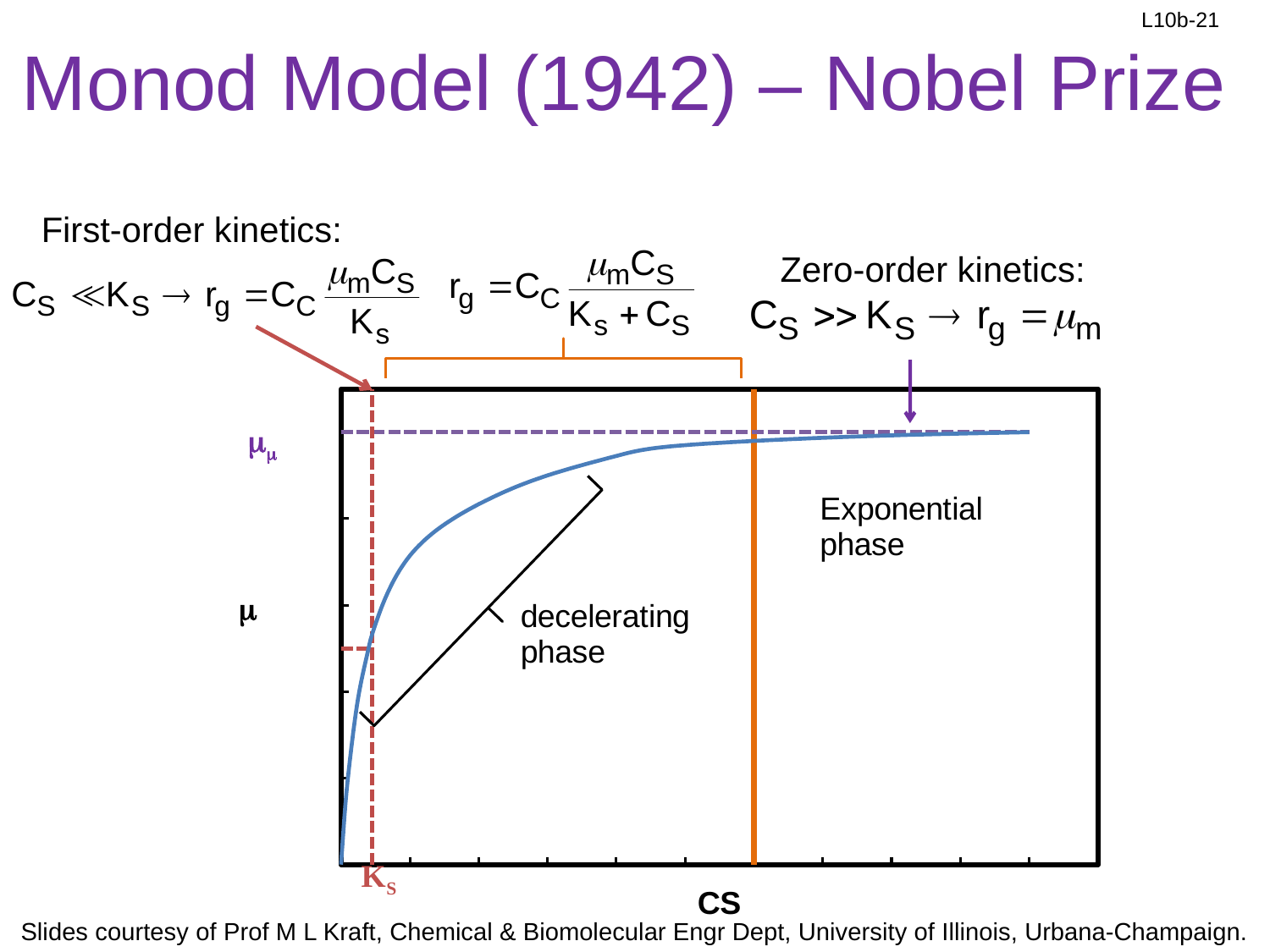
As CS increases along the x axis, does the plotted curve rise or fall? rise Is the value of the curve at Ks greater or less than the dashed horizontal line at μm? less How many curves are plotted on the chart? 1 What is the label on the x axis of the chart? CS Which phase is labelled to the right of the orange vertical line on the chart? Exponential phase What kind of chart is shown on the slide? line chart